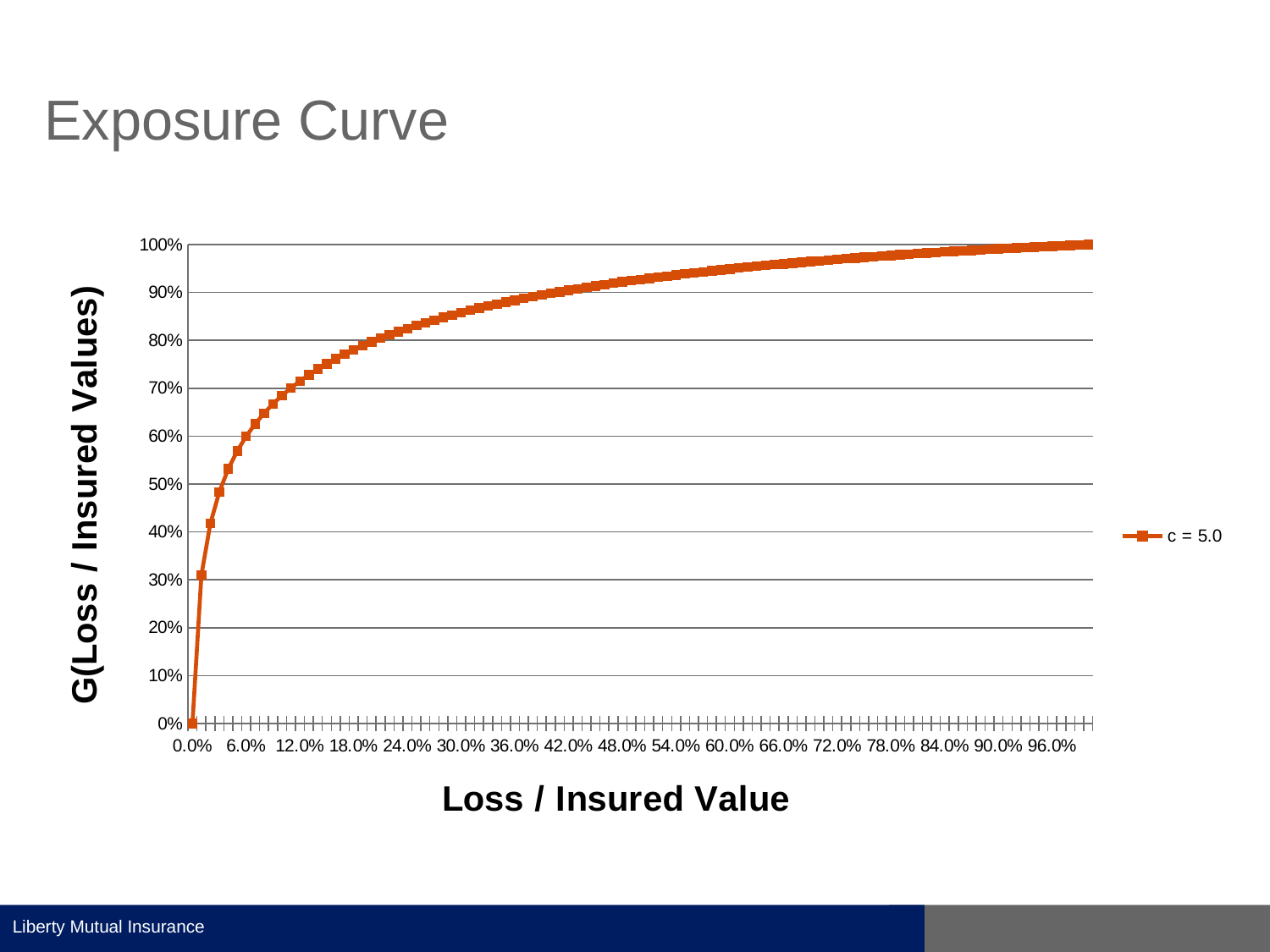
What is the name of the series shown in the legend? c = 5.0 Is the value of the curve at a Loss / Insured Value of 48.0% greater or less than 80%? greater Is the value of the curve at a Loss / Insured Value of 60.0% greater or less than 90%? greater Is the value of the curve at a Loss / Insured Value of 12.0% greater or less than 50%? greater What is the value of G(Loss / Insured Values) at a Loss / Insured Value of 0.0%? 0% How many series does the legend list? 1 What is the title of the x axis? Loss / Insured Value Do the values rise or fall as Loss / Insured Value increases along the x axis? rise What kind of chart is shown on the slide? line chart Which of the two points has the larger value: the curve at 6.0% or the curve at 36.0% Loss / Insured Value? 36.0%